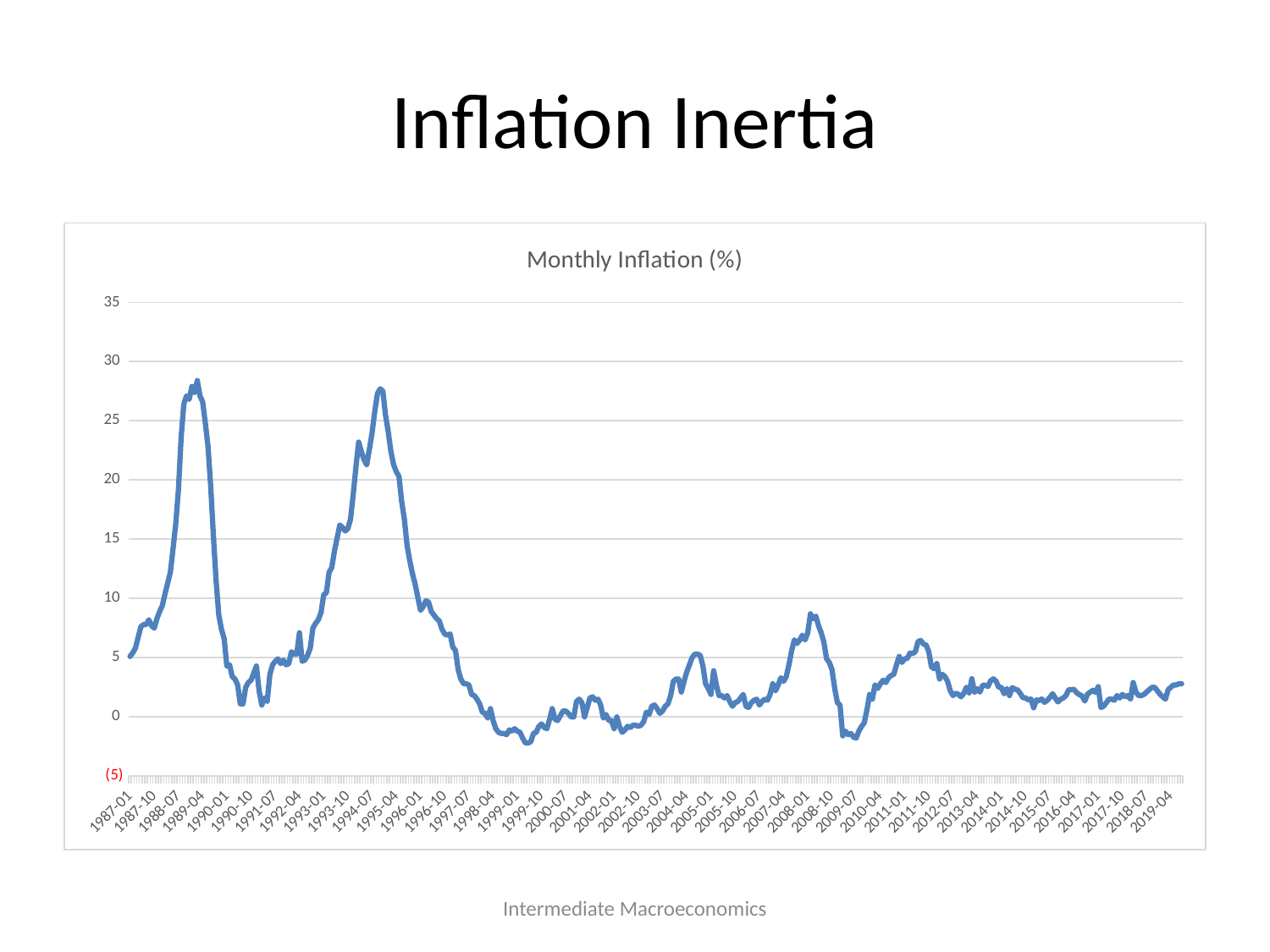
Does monthly inflation rise or fall between 1993-01 and 1995-04? rise Is the value of monthly inflation around 1999-01 greater or less than 0? less What kind of chart is shown on the slide? line chart What is the highest value shown on the vertical axis of the chart? 35 Is the value of monthly inflation at 2019-04 greater or less than 5? less What is the title of the chart? Monthly Inflation (%) Is the peak value of monthly inflation around 2008-01 greater or less than 10? less Which is higher: the peak of monthly inflation around 1989-04 or the peak around 2008-01? the peak around 1989-04 How many lines are plotted on the chart? 1 Does monthly inflation rise or fall between 1989-04 and 1990-01? fall